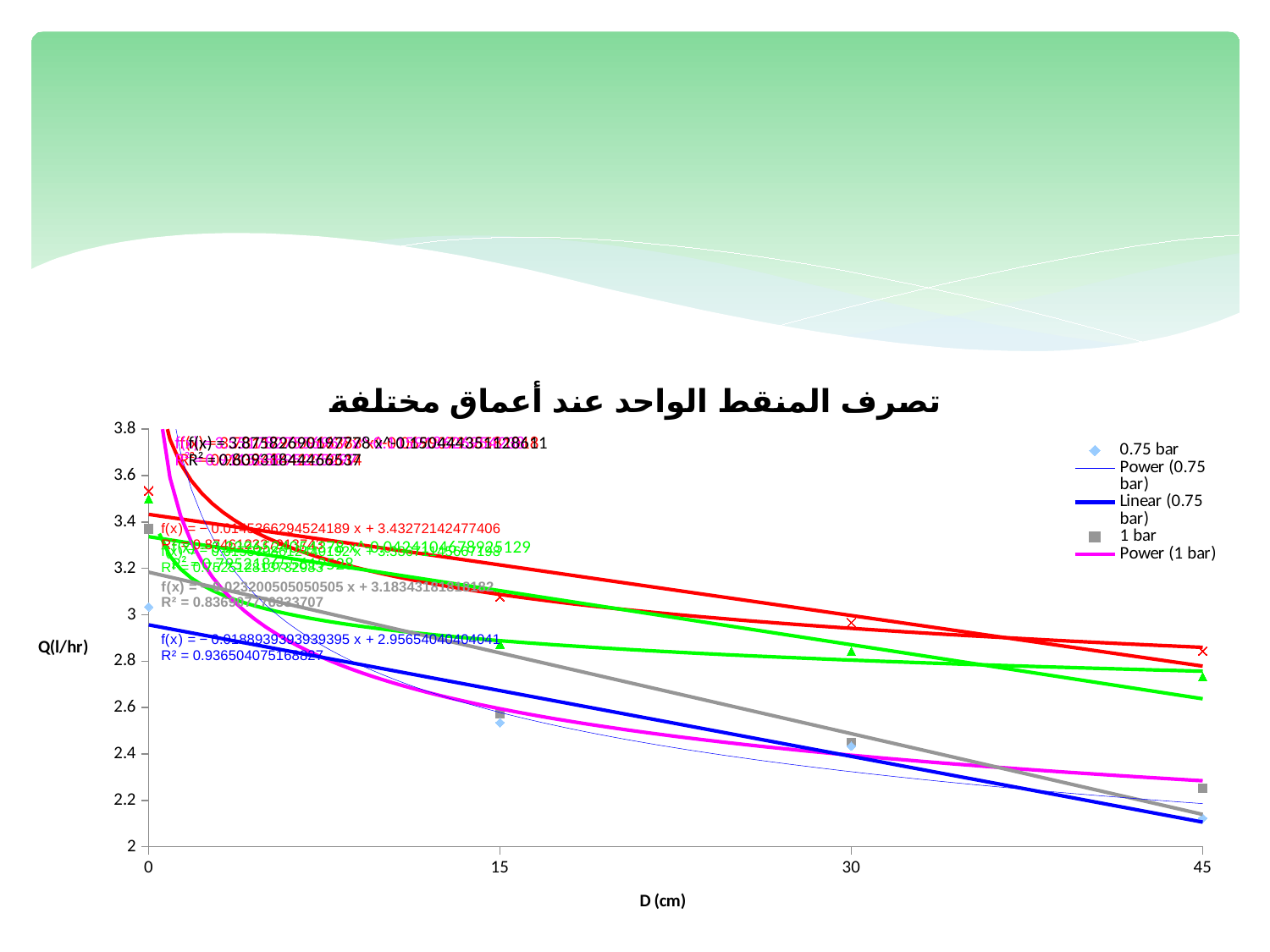
What kind of chart is shown on the slide? scatter chart What is the title of the y axis? Q(l/hr) Do the plotted Q values rise or fall as D increases from 0 to 45 cm? fall What is the title of the x axis? D (cm) Is the value for the 1 bar series at D = 30 greater or less than 2.6? less How many depth values (D) are plotted along the x axis? 4 At D = 0, which is larger: the 0.75 bar value or the 1 bar value? 1 bar At D = 45, which is larger: the 0.75 bar value or the 1 bar value? 1 bar At which depth D does the 0.75 bar series reach its lowest value? 45 Is the value for the 0.75 bar series at D = 45 greater or less than 2.2? less Is the value for the 0.75 bar series at D = 15 greater or less than 2.6? less